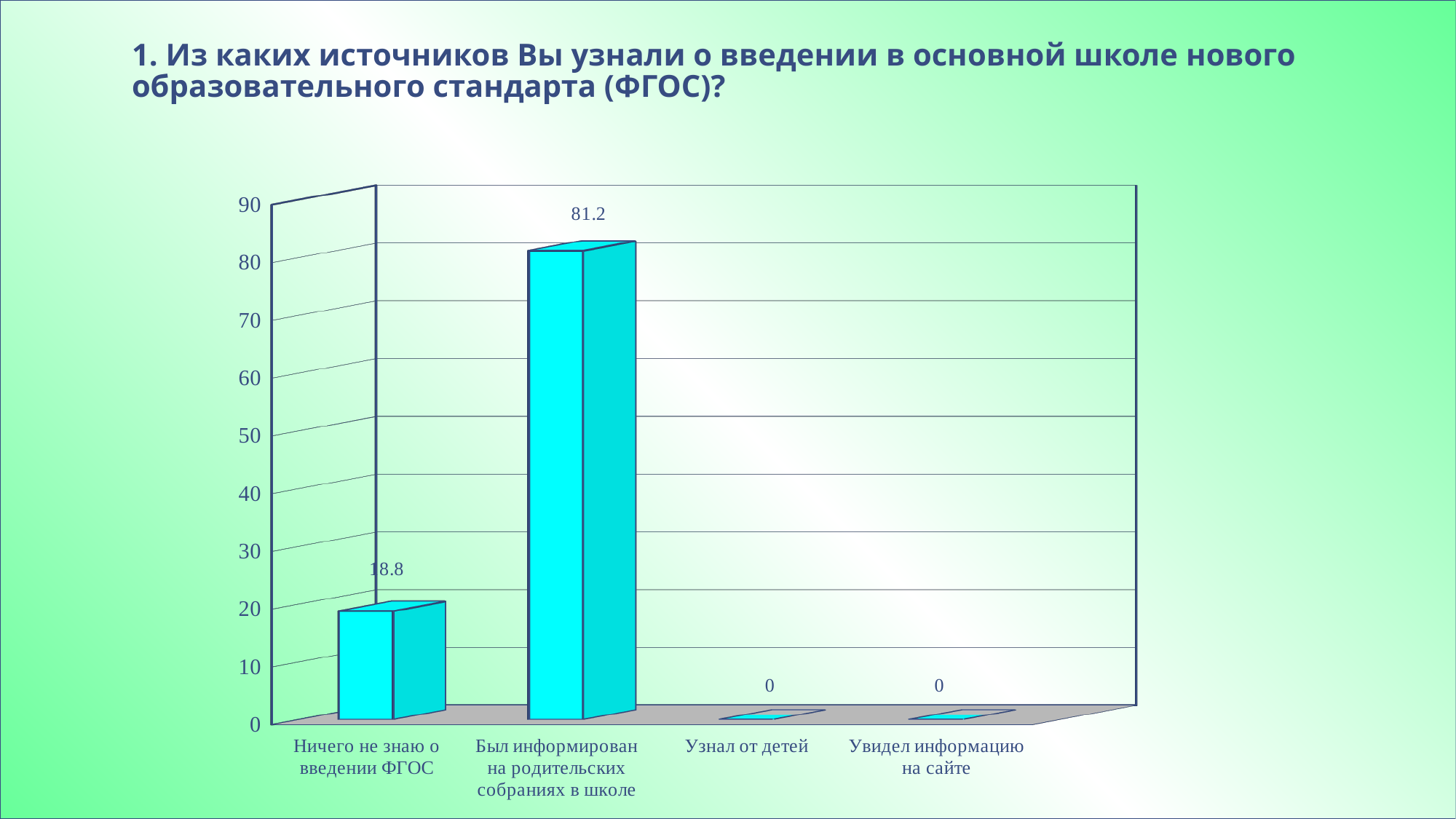
Is the value for "Был информирован на родительских собраниях в школе" greater or less than 80? greater How many categories have a value of 0? 2 What is the value for "Узнал от детей"? 0 Is the value for "Ничего не знаю о введении ФГОС" greater or less than 20? less What kind of chart is shown on the slide? bar chart Which is larger: the value for "Ничего не знаю о введении ФГОС" or the value for "Узнал от детей"? Ничего не знаю о введении ФГОС What is the difference between the values for "Был информирован на родительских собраниях в школе" and "Ничего не знаю о введении ФГОС"? 62.4 What is the value for "Был информирован на родительских собраниях в школе"? 81.2 How many categories are shown on the x axis? 4 What is the value for "Увидел информацию на сайте"? 0 Which category has the highest value? Был информирован на родительских собраниях в школе What is the value for "Ничего не знаю о введении ФГОС"? 18.8